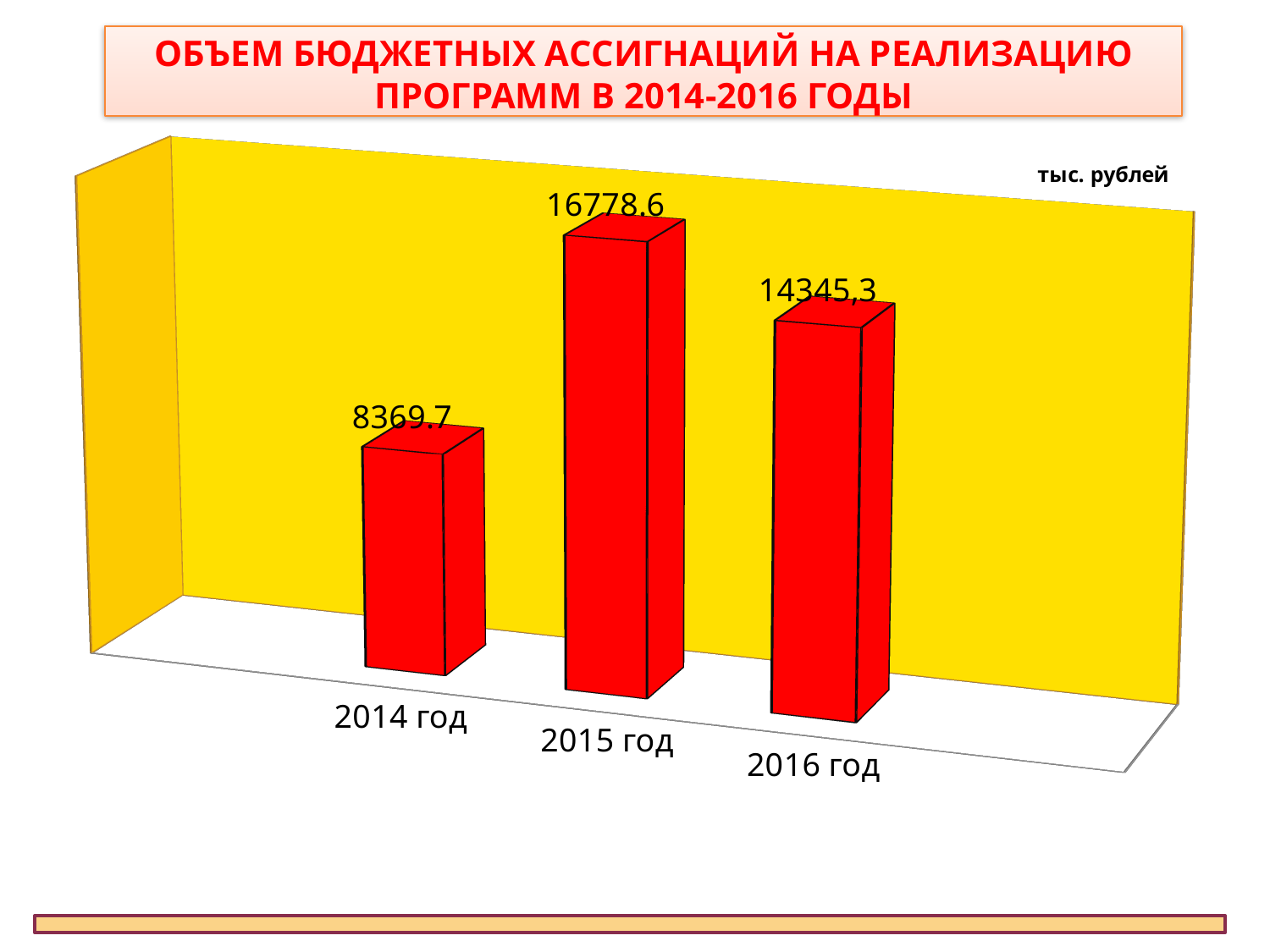
How many years (categories) are shown in the chart? 3 What is the value for 2014 год? 8369.7 Which year has the lowest value? 2014 год What is the value for 2015 год? 16778.6 What is the difference between the values for 2015 год and 2016 год? 2433.3 What is the value for 2016 год? 14345,3 What unit of measurement is indicated on the chart? тыс. рублей What is the difference between the values for 2015 год and 2014 год? 8408.9 What colour are the bars in the chart? red What kind of chart is shown on the slide? bar chart Which year has the highest value? 2015 год Which is larger, the value for 2016 год or the value for 2014 год? 2016 год